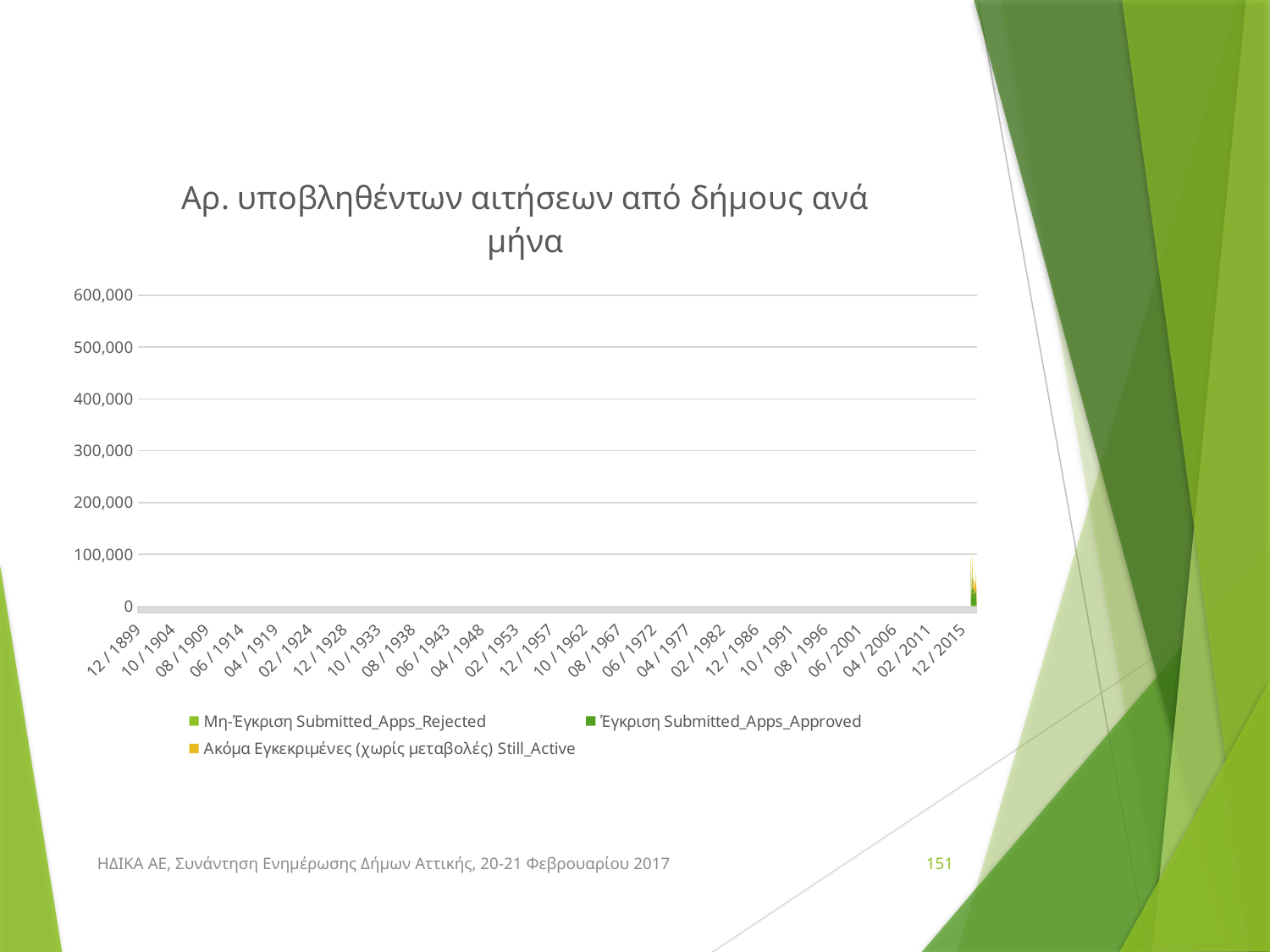
What kind of chart is shown on the slide? Area chart Do the plotted values stay flat or rise along most of the x axis before the final spike? They stay flat near zero What is the title of the chart? Αρ. υποβληθέντων αιτήσεων από δήμους ανά μήνα Which legend entry corresponds to the series 'Still_Active'? Ακόμα Εγκεκριμένες (χωρίς μεταβολές) Still_Active How many series does the chart's legend list? 3 Is the peak value reached at the right end of the chart greater or less than 200,000? less What is the last label on the horizontal axis of the chart? 12 / 2015 What is the first label on the horizontal axis of the chart? 12 / 1899 Near which end of the x axis do the values rise sharply? The right end (around 12 / 2015) What is the highest value shown on the vertical axis of the chart? 600,000